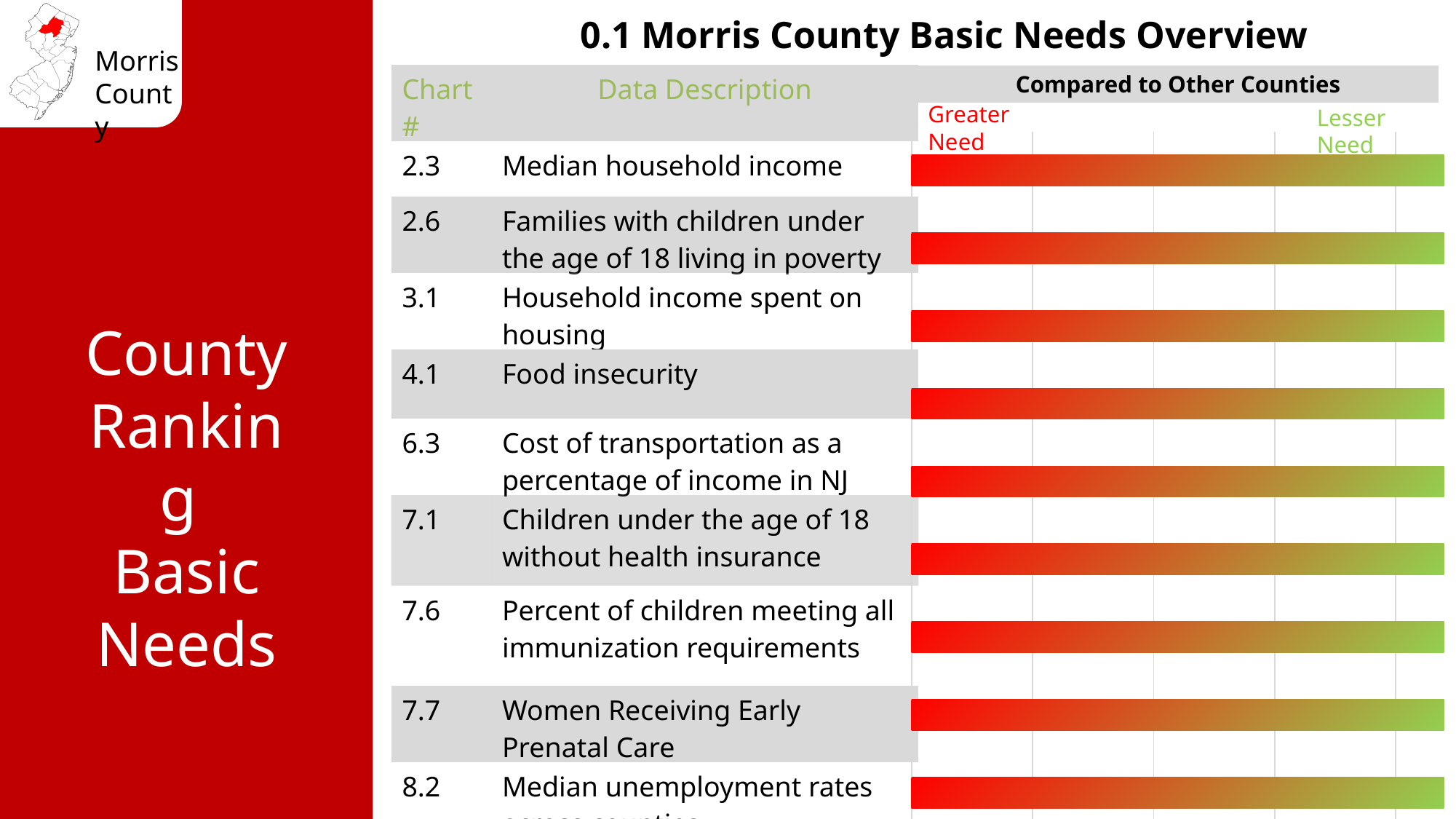
How many rows in the 0.1 Morris County Basic Needs Overview have a Chart # beginning with 7? 3 In the 0.1 Morris County Basic Needs Overview, what is the Chart # for "Food insecurity"? 4.1 How many data description rows (bars) are shown in the 0.1 Morris County Basic Needs Overview? 9 In the 0.1 Morris County Basic Needs Overview, what is the Data Description for Chart # 7.7? Women Receiving Early Prenatal Care What is the title of the chart on the slide? 0.1 Morris County Basic Needs Overview What label appears at the left (red) end of the bars in the "Compared to Other Counties" column? Greater Need In the 0.1 Morris County Basic Needs Overview, what is the Chart # for "Median household income"? 2.3 In the 0.1 Morris County Basic Needs Overview, what is the Chart # for "Children under the age of 18 without health insurance"? 7.1 What kind of chart is used in the "Compared to Other Counties" column of the 0.1 Morris County Basic Needs Overview? bar chart In the 0.1 Morris County Basic Needs Overview, what is the Data Description for Chart # 6.3? Cost of transportation as a percentage of income in NJ